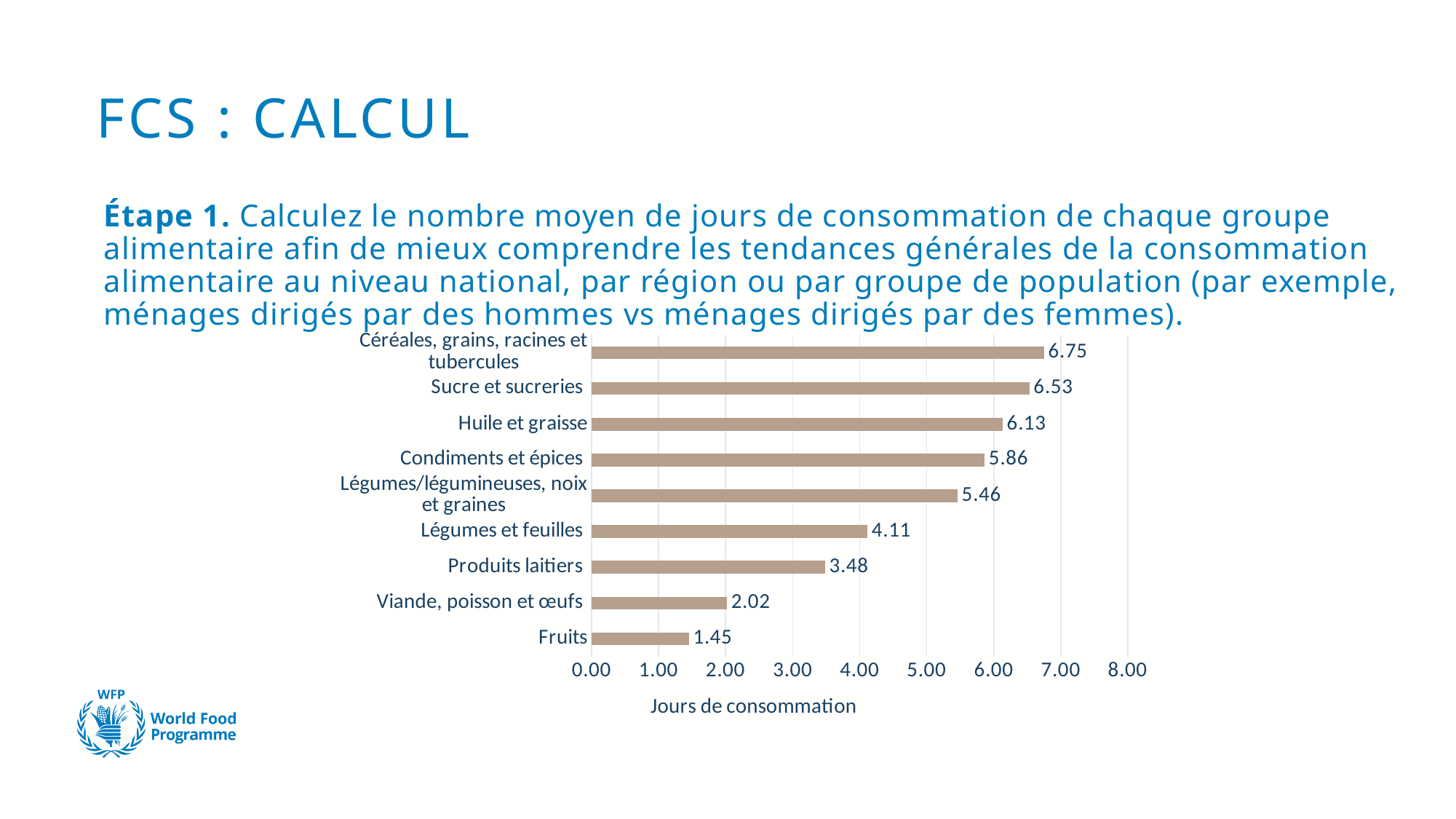
What is the difference between the values for Viande, poisson et œufs and Fruits? 0.57 What is the value for Sucre et sucreries? 6.53 Is the value for Condiments et épices greater or less than 5.00? greater What is the difference between the values for Huile et graisse and Condiments et épices? 0.27 What is the value for Produits laitiers? 3.48 What is the label of the horizontal axis? Jours de consommation Which category has the highest value? Céréales, grains, racines et tubercules How many categories are shown in the chart? 9 Which is larger, the value for Légumes/légumineuses, noix et graines or the value for Légumes et feuilles? Légumes/légumineuses, noix et graines What kind of chart is shown on the slide? bar chart Which category has the lowest value? Fruits What is the value for Légumes et feuilles? 4.11